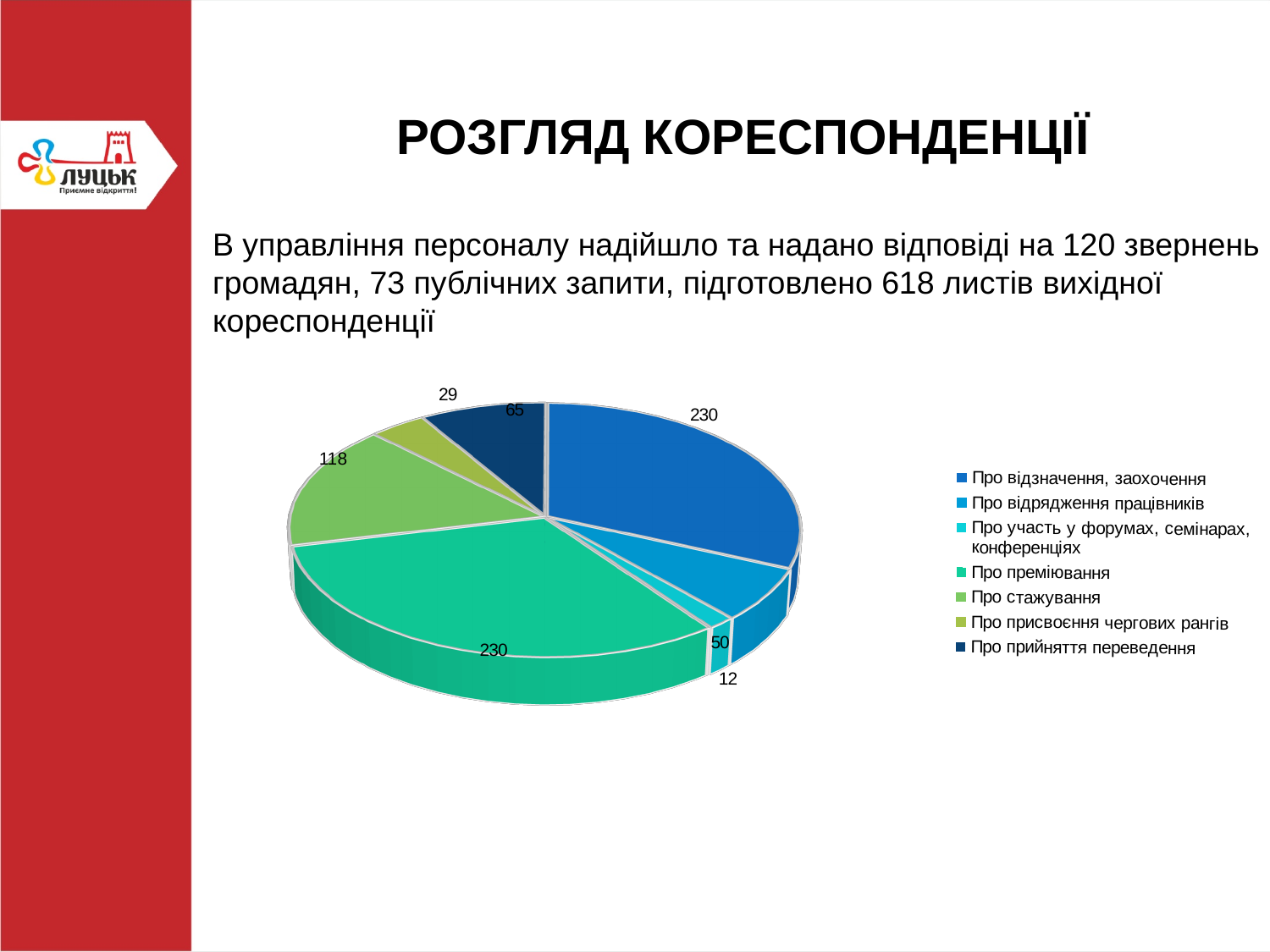
What is the difference between the values for "Про відзначення, заохочення" and "Про відрядження працівників"? 180 Which category has the smallest slice in the pie chart? Про участь у форумах, семінарах, конференціях What is the total of all the values shown in the pie chart? 734 What value is shown for the slice "Про прийняття переведення"? 65 What value is shown for the slice "Про відрядження працівників"? 50 Which is larger, the value for "Про прийняття переведення" or the value for "Про присвоєння чергових рангів"? Про прийняття переведення Which legend entry is shown in the darkest navy colour? Про прийняття переведення What value is shown for the slice "Про стажування"? 118 What is the difference between the values for "Про стажування" and "Про прийняття переведення"? 53 How many categories does the pie chart show? 7 What value is shown for the slice "Про присвоєння чергових рангів"? 29 What type of chart is shown on the slide? Pie chart